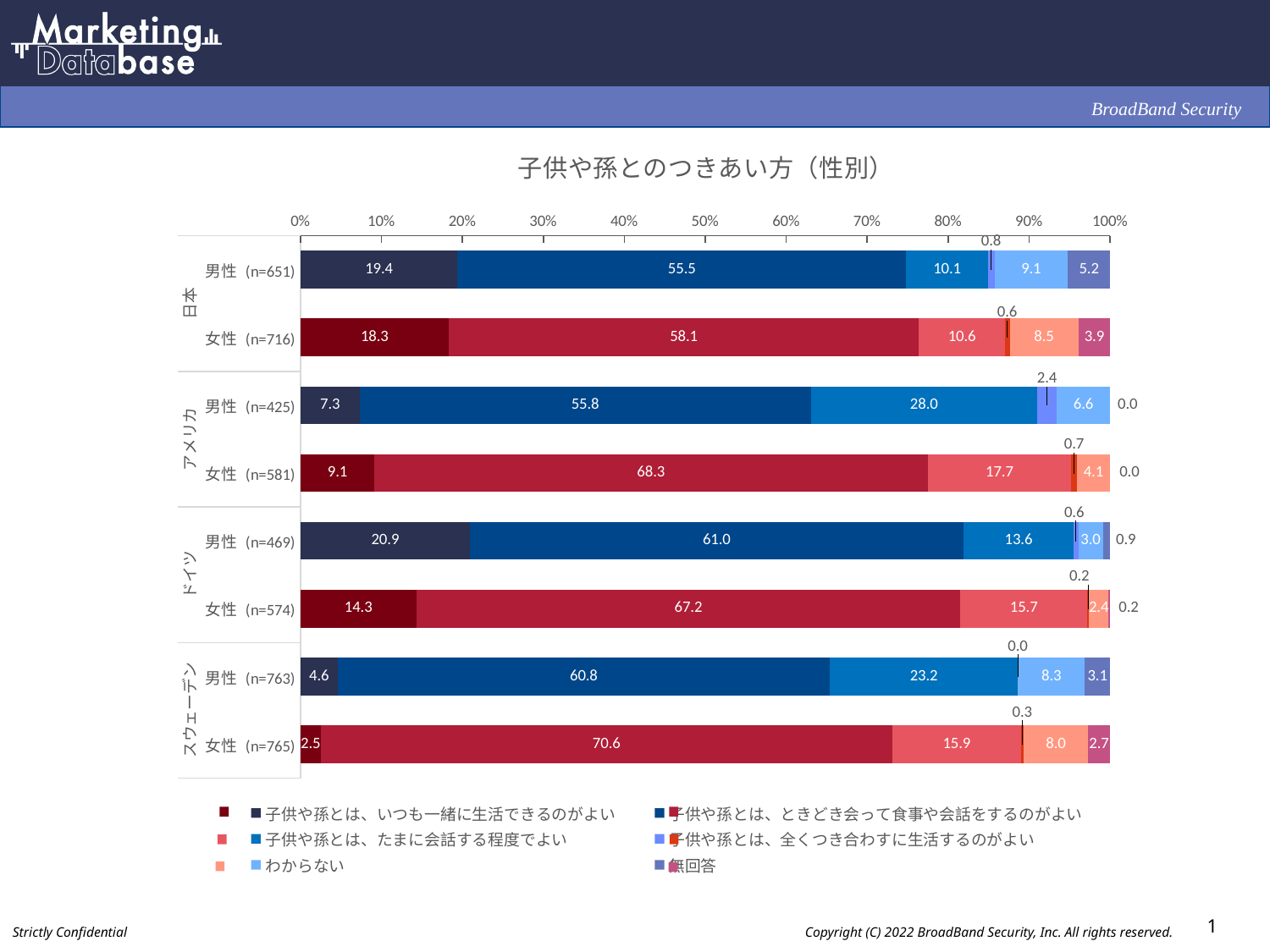
How many groups (bars) are shown in the chart? 8 Which group has the highest value for 「子供や孫とは、ときどき会って食事や会話をするのがよい」? スウェーデン 女性 (n=765) What is the value for 「子供や孫とは、ときどき会って食事や会話をするのがよい」 for スウェーデン 女性 (n=765)? 70.6 What kind of chart is shown on the slide? Stacked bar chart What is the title of the chart? 子供や孫とのつきあい方（性別） What is the value for 「わからない」 for 日本 男性 (n=651)? 9.1 Which is larger: the 「子供や孫とは、たまに会話する程度でよい」 value for スウェーデン 男性 (n=763) or for ドイツ 女性 (n=574)? スウェーデン 男性 (n=763) What is the difference between the 「子供や孫とは、ときどき会って食事や会話をするのがよい」 values for アメリカ 女性 (n=581) and アメリカ 男性 (n=425)? 12.5 What is the value for 「子供や孫とは、たまに会話する程度でよい」 for アメリカ 男性 (n=425)? 28.0 Which group has the lowest value for 「子供や孫とは、いつも一緒に生活できるのがよい」? スウェーデン 女性 (n=765) What is the value for 「子供や孫とは、いつも一緒に生活できるのがよい」 for ドイツ 男性 (n=469)? 20.9 How many series does the legend list? 6